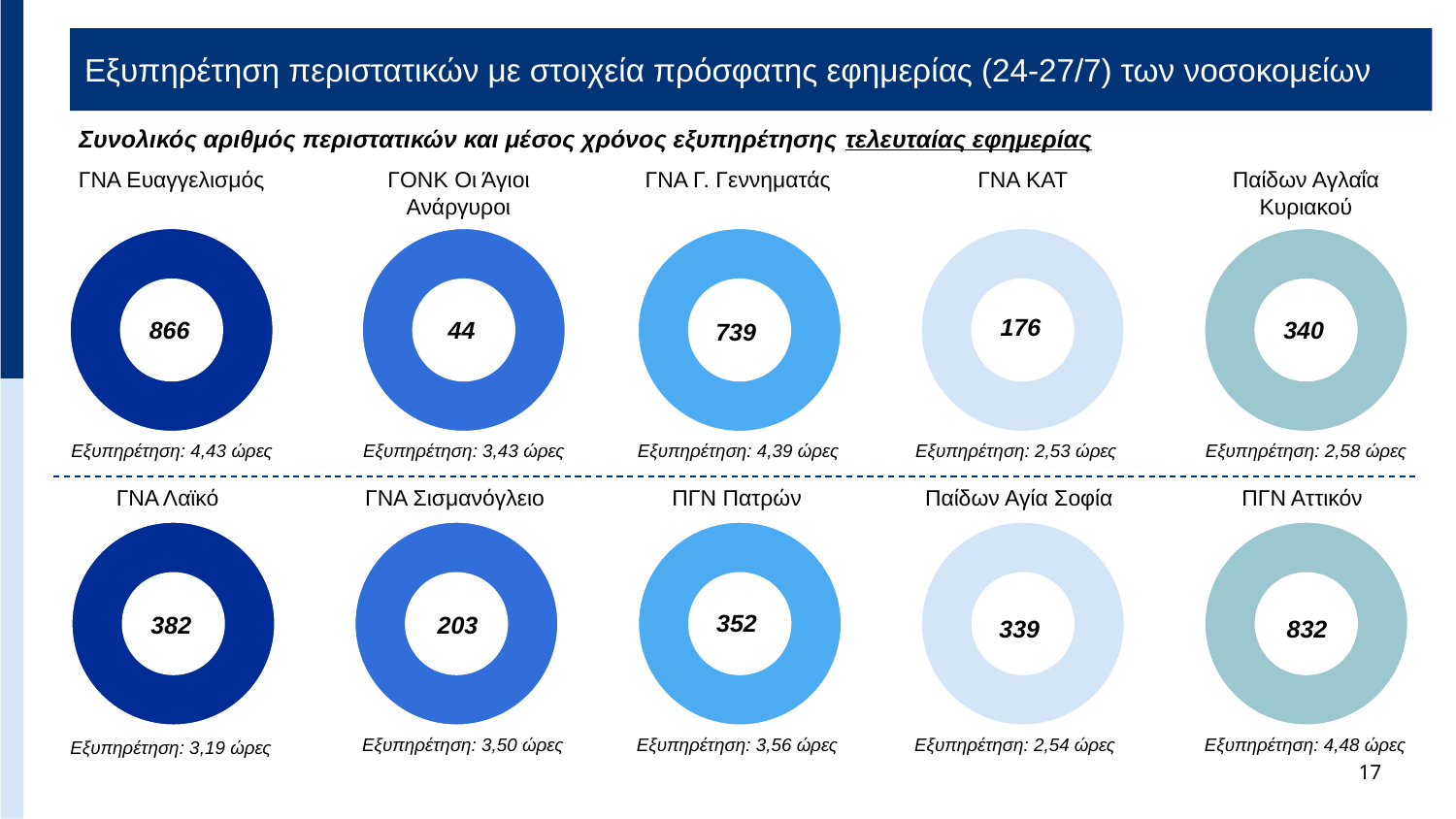
What number is shown in the centre of the ΓΟΝΚ Οι Άγιοι Ανάργυροι donut chart? 44 What number is shown in the centre of the ΓΝΑ Ευαγγελισμός donut chart? 866 Which has more cases, ΓΝΑ Λαϊκό or ΠΓΝ Πατρών? ΓΝΑ Λαϊκό What type of chart is used for each hospital on the slide? Donut chart What is the difference between the number of cases for ΓΝΑ Ευαγγελισμός and ΠΓΝ Αττικόν? 34 What number is shown in the centre of the ΠΓΝ Αττικόν donut chart? 832 Which hospital's donut chart shows the lowest number of cases? ΓΟΝΚ Οι Άγιοι Ανάργυροι What is the service time (Εξυπηρέτηση) printed under the ΓΝΑ ΚΑΤ chart? 2,53 ώρες What is the service time (Εξυπηρέτηση) printed under the ΠΓΝ Πατρών chart? 3,56 ώρες Which hospital's donut chart shows the highest number of cases? ΓΝΑ Ευαγγελισμός Which hospital has the longest service time (Εξυπηρέτηση) shown on the slide? ΠΓΝ Αττικόν How many donut charts are shown on the slide? 10